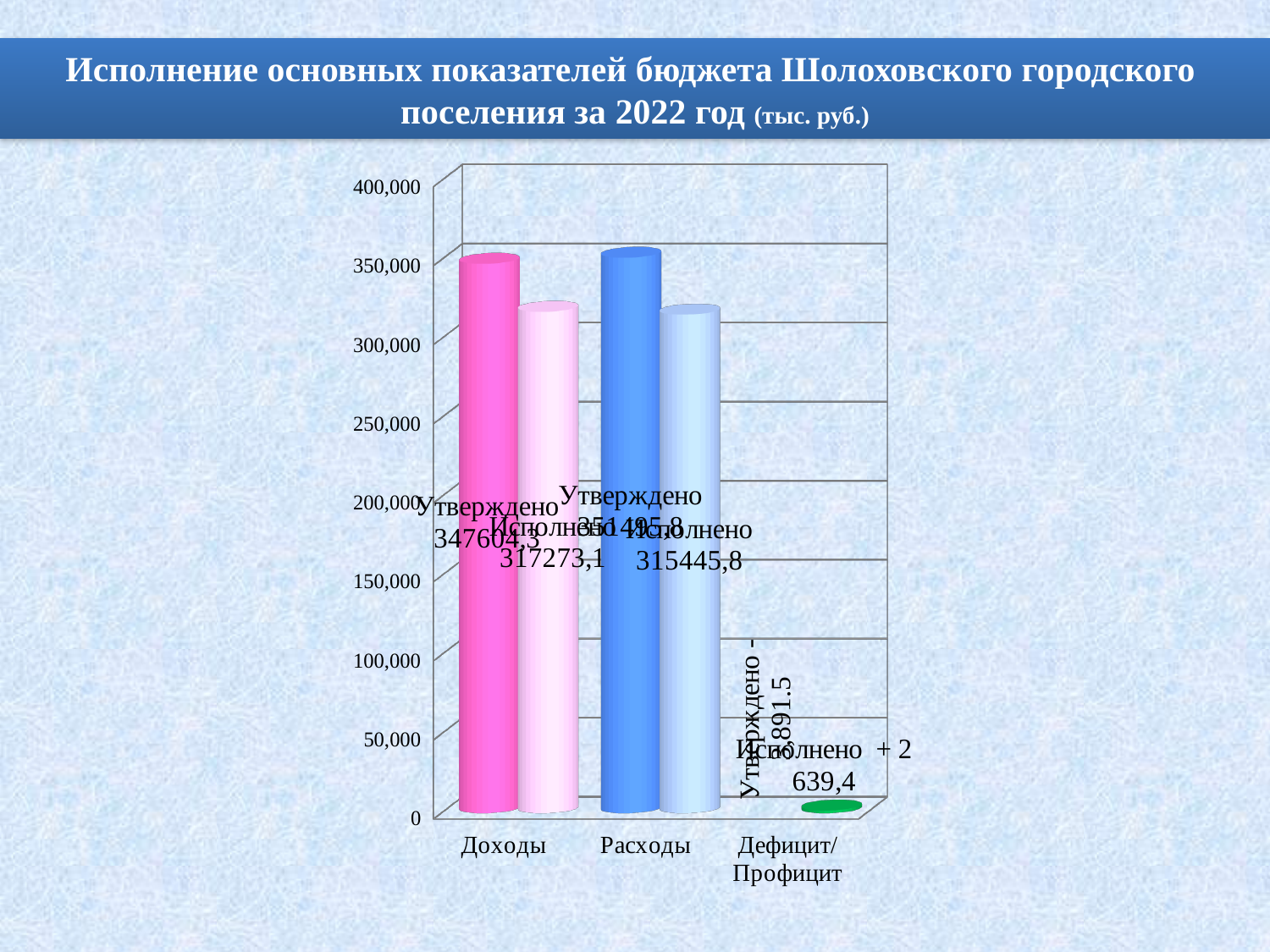
How many categories are shown on the x axis? 3 Is the executed (Исполнено) value for Доходы greater or less than 300,000? greater What is the executed (Исполнено) value for Расходы? 315445,8 Is the executed (Исполнено) value for Расходы greater or less than 350,000? less What is the approved (Утверждено) value for Доходы? 347604,3 What is the difference between the approved and executed values for Доходы? 30331,2 Which is larger for Доходы: the approved (Утверждено) value or the executed (Исполнено) value? Утверждено What is the highest tick value shown on the vertical axis? 400,000 What is the executed (Исполнено) value for Доходы? 317273,1 In what units are the values on the chart given, according to the slide title? тыс. руб. What kind of chart is shown on the slide? bar chart Is the value for Дефицит/Профицит greater or less than 50,000? less